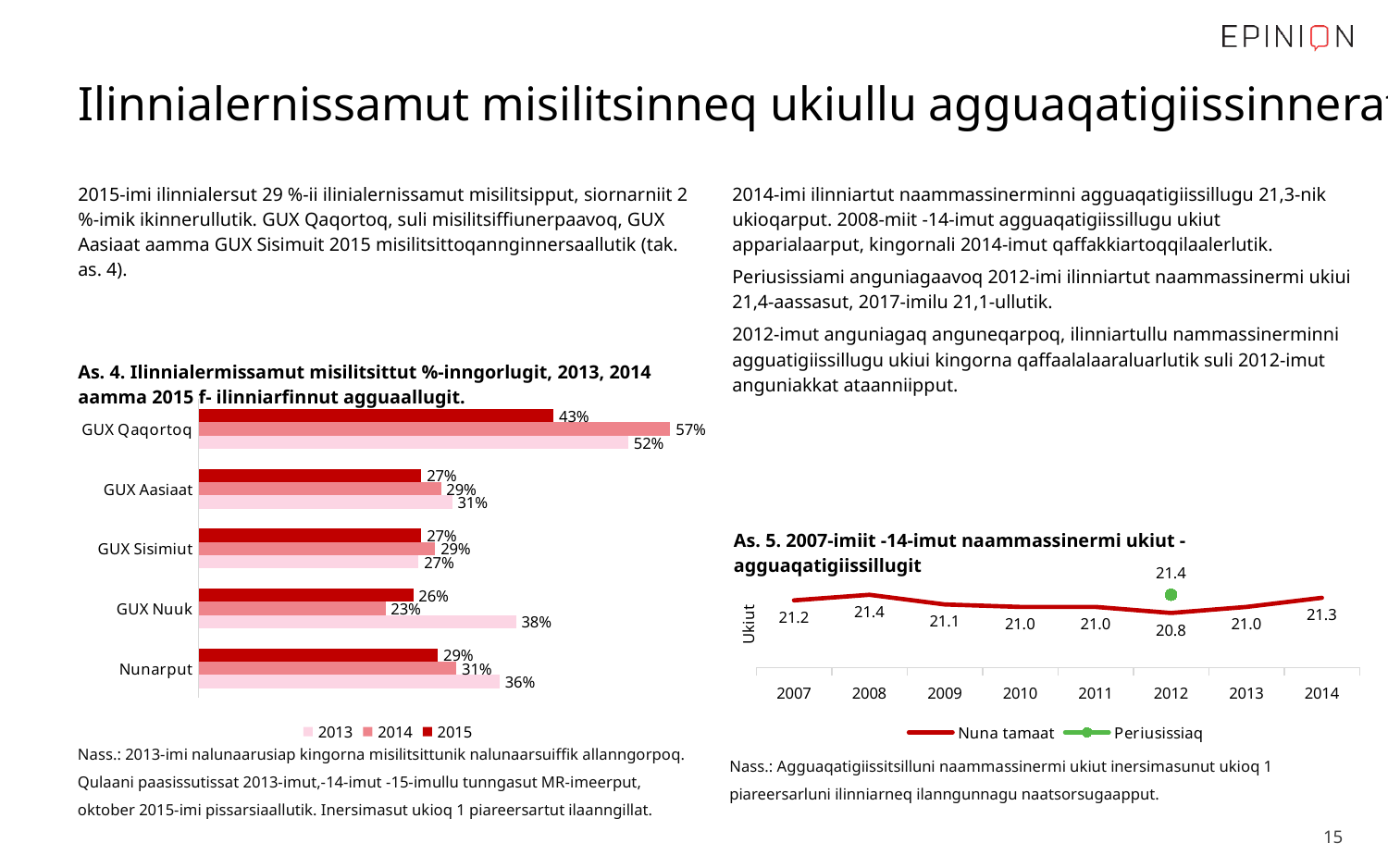
In the chart 'As. 4', what is the difference between the 2013 and 2015 values for Nunarput? 7% In the chart 'As. 4', what is the 2014 value for GUX Qaqortoq? 57% In the chart 'As. 4', which is larger for GUX Nuuk: the 2013 value or the 2014 value? 2013 In the chart 'As. 4', how many categories are shown on the vertical axis? 5 In the chart 'As. 5', which year has the lowest Nuna tamaat value? 2012 In the chart 'As. 4', which category has the highest 2015 value? GUX Qaqortoq In the chart 'As. 4', what is the 2013 value for GUX Nuuk? 38% In the chart 'As. 5', what is the Nuna tamaat value for 2012? 20.8 In the chart 'As. 5', what is the Periusissiaq value shown for 2012? 21.4 What kind of chart is 'As. 4'? Bar chart In the chart 'As. 5', what is the difference between the Nuna tamaat values for 2008 and 2012? 0.6 In the chart 'As. 4', how many series does the legend list? 3